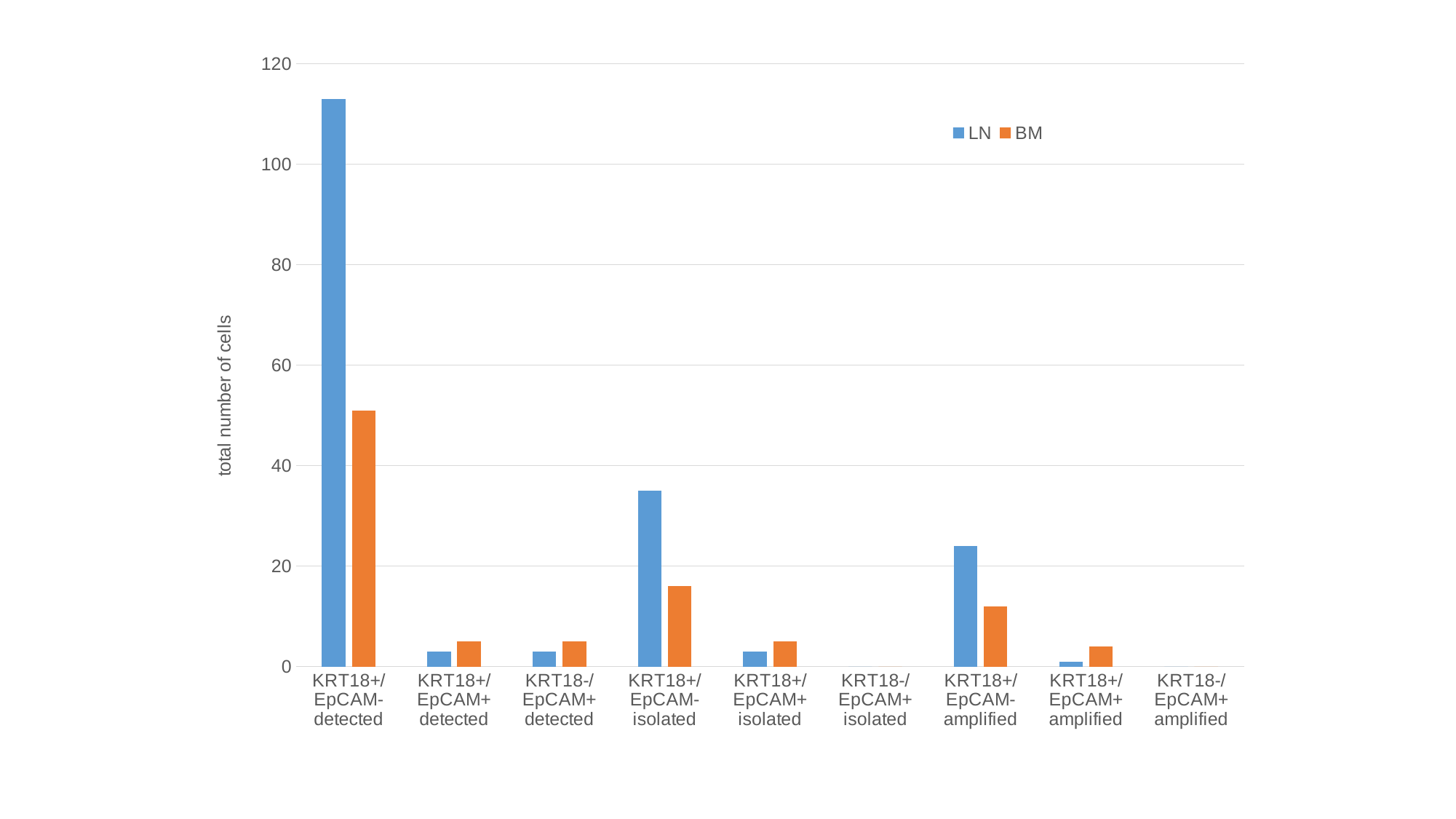
For KRT18+/EpCAM- detected, which series has the larger value, LN or BM? LN Is the BM value for KRT18+/EpCAM- detected greater or less than 60? less What is the label on the y axis? total number of cells What kind of chart is shown on the slide? bar chart How many categories are shown on the x axis? 9 Which category has the highest LN value? KRT18+/EpCAM- detected For KRT18+/EpCAM+ amplified, which series has the larger value, LN or BM? BM Is the LN value for KRT18+/EpCAM- isolated greater or less than 40? less Is the LN value for KRT18+/EpCAM- detected greater or less than 100? greater How many series does the legend list? 2 Which category has the highest BM value? KRT18+/EpCAM- detected